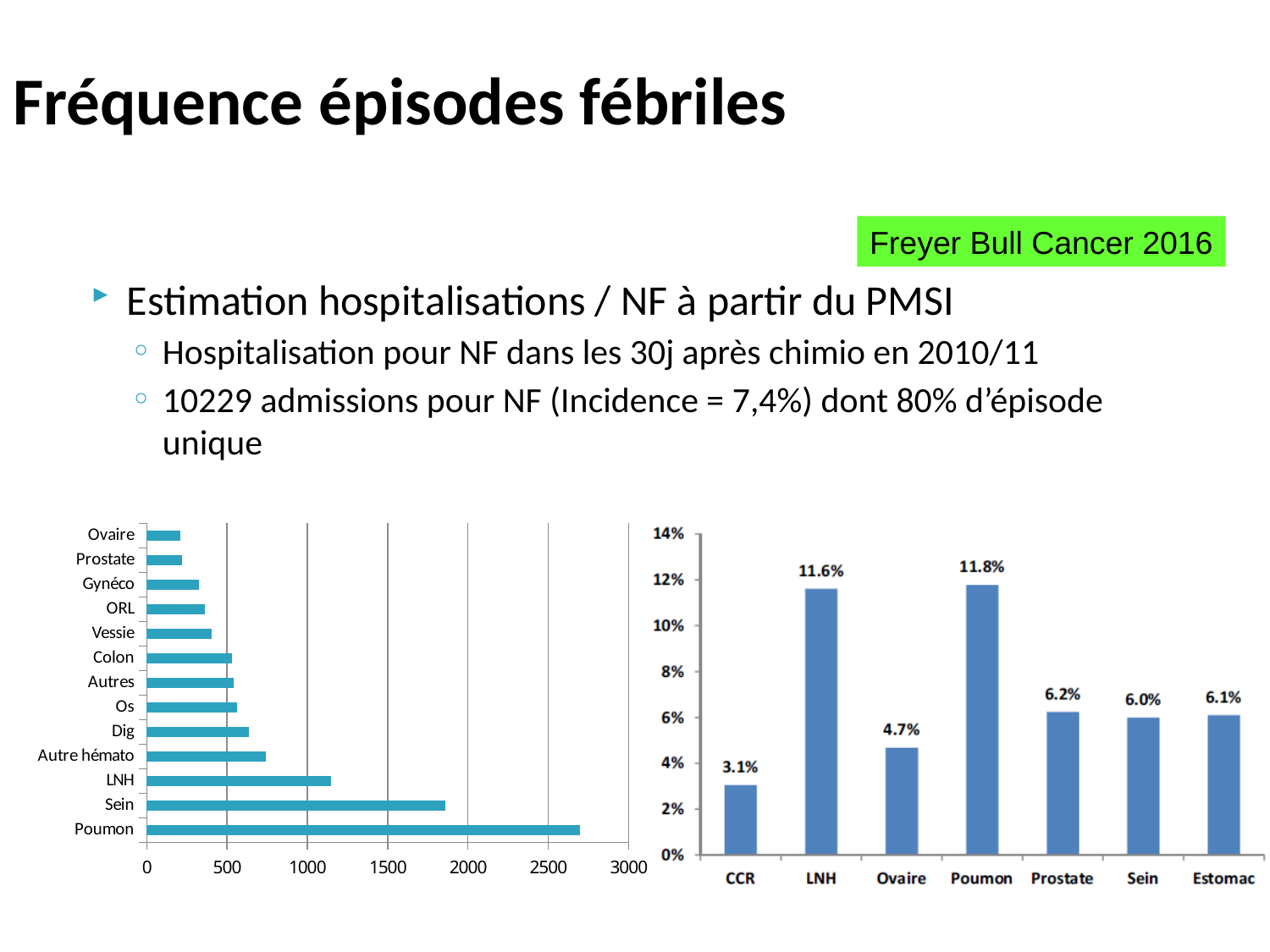
In the right-hand chart, which is larger, the value for Prostate or the value for Sein? Prostate In the right-hand chart, what is the value for Ovaire? 4.7% What kind of chart is the left-hand chart? Bar chart How many categories are shown in the right-hand chart? 7 In the left-hand chart, which category has the longest bar? Poumon How many categories are shown in the left-hand chart? 13 In the right-hand chart, which category has the highest value? Poumon In the right-hand chart, what is the difference between the values for Poumon and CCR? 8.7% In the right-hand chart, what is the value for LNH? 11.6% In the right-hand chart, what is the value for Estomac? 6.1% In the left-hand chart, is the value for Sein greater or less than 1500? greater In the right-hand chart, which category has the lowest value? CCR